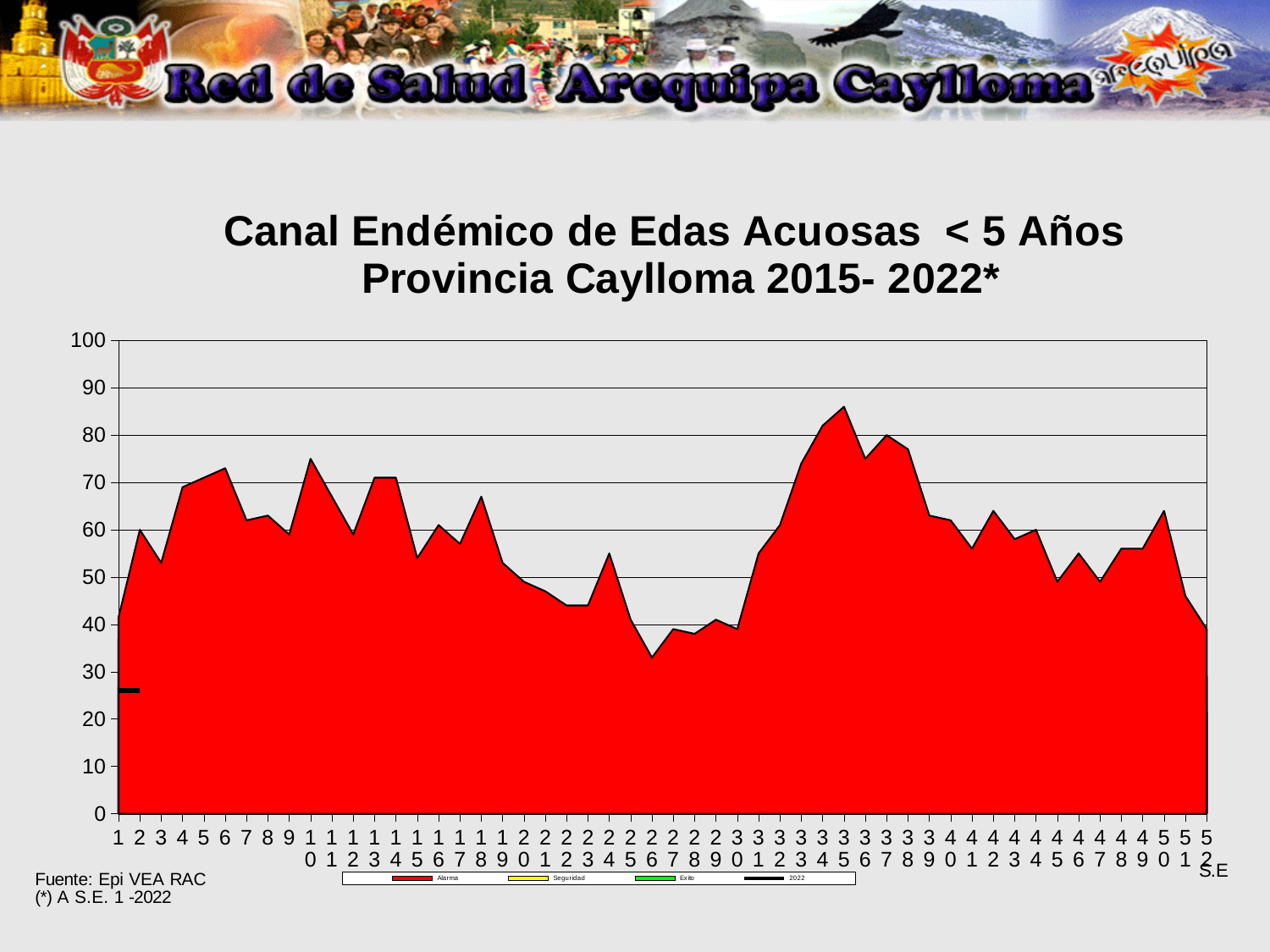
Is the value of the red Alarma area at week 52 greater or less than 50? less Is the value of the red Alarma area at week 26 greater or less than 40? less Is the value of the red Alarma area at week 1 greater or less than 50? less Between week 26 and week 35, do the values of the red Alarma area rise or fall? rise How many epidemiological weeks (S.E.) are shown along the x axis? 52 What is the title of the chart? Canal Endémico de Edas Acuosas < 5 Años Provincia Caylloma 2015- 2022* At which week does the red Alarma area reach its highest value? Week 35 Which legend entry is shown in red? Alarma What kind of chart is shown on the slide? Area chart How many entries does the chart legend list? 4